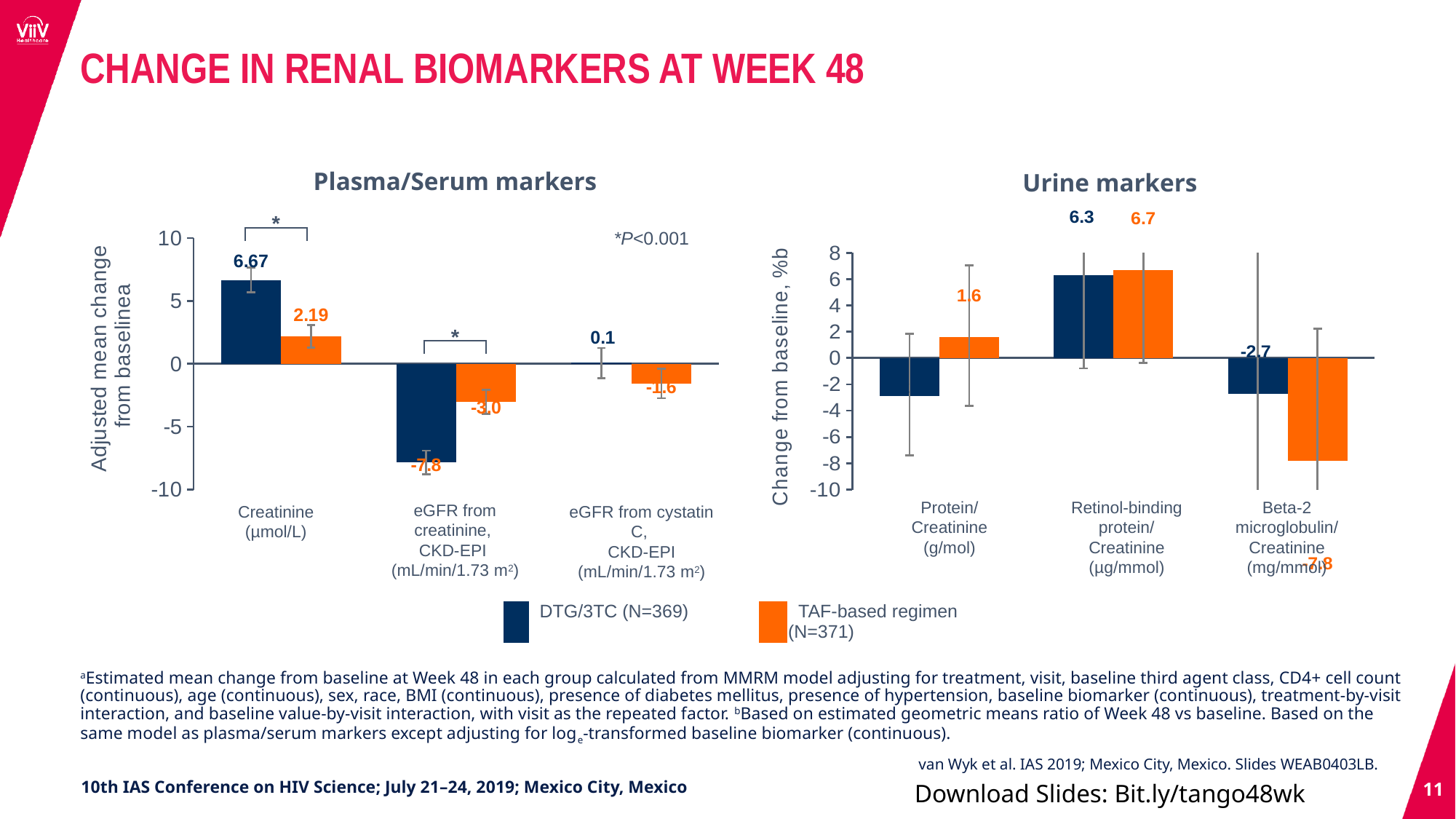
In the Plasma/Serum markers chart, what is the adjusted mean change from baseline in creatinine for the TAF-based regimen? 2.19 How many series does the legend list for the charts? 2 What kind of chart is the Urine markers chart? bar chart In the Plasma/Serum markers chart, what is the value for the TAF-based regimen for eGFR from cystatin C, CKD-EPI? -1.6 In the Plasma/Serum markers chart, what is the adjusted mean change from baseline in creatinine for DTG/3TC? 6.67 In the Urine markers chart, what is the change from baseline in Beta-2 microglobulin/Creatinine for the TAF-based regimen? -7.8 In the Urine markers chart, is the DTG/3TC value for Protein/Creatinine greater or less than 0? less In the Plasma/Serum markers chart, which group has the larger decrease in eGFR from creatinine, CKD-EPI? DTG/3TC In the Urine markers chart, what is the change from baseline in Protein/Creatinine for the TAF-based regimen? 1.6 In the Urine markers chart, what is the change from baseline in Retinol-binding protein/Creatinine for the TAF-based regimen? 6.7 In the Plasma/Serum markers chart, what is the value for DTG/3TC for eGFR from creatinine, CKD-EPI? -7.8 In the Plasma/Serum markers chart, what is the difference between the DTG/3TC and TAF-based regimen values for creatinine? 4.48